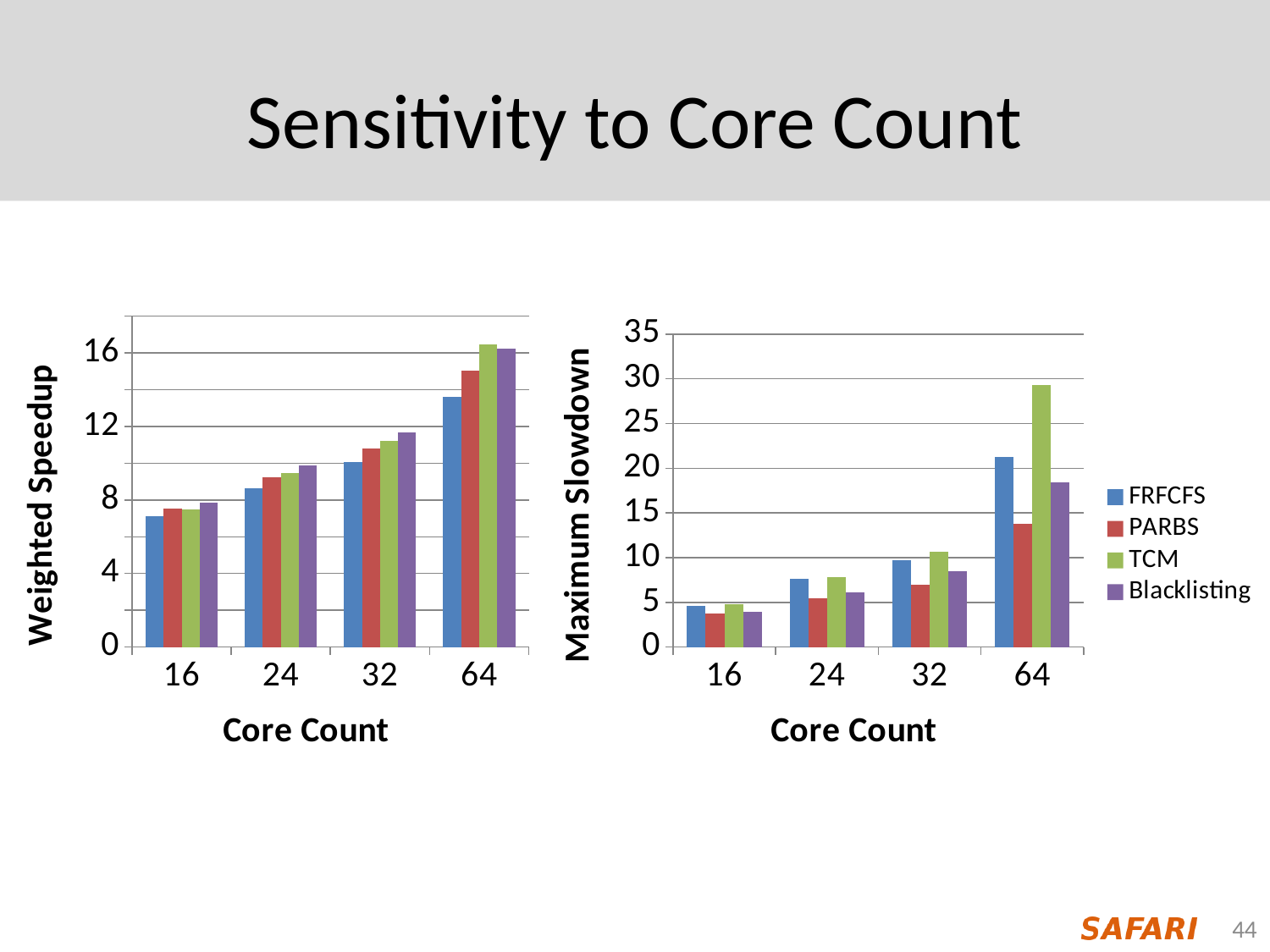
In the Weighted Speedup chart on the left, do the FRFCFS values rise or fall as the core count increases from 16 to 64? rise In the Maximum Slowdown chart on the right, which series has the lowest value at 64 cores? PARBS What kind of chart is the Weighted Speedup chart on the left? bar chart In the Weighted Speedup chart on the left, which series has the lowest value at 64 cores? FRFCFS In the Maximum Slowdown chart on the right, which is larger at 64 cores: FRFCFS or Blacklisting? FRFCFS What is the y-axis title of the chart on the right? Maximum Slowdown In the Maximum Slowdown chart on the right, which series has the highest value at 64 cores? TCM How many series does the legend list for the charts? 4 In the Weighted Speedup chart on the left, is the value for FRFCFS at 64 cores greater or less than 12? greater In the Maximum Slowdown chart on the right, how many core count categories are shown on the x axis? 4 In the Maximum Slowdown chart on the right, is the value for TCM at 64 cores greater or less than 25? greater In the Maximum Slowdown chart on the right, is the value for PARBS at 64 cores greater or less than 15? less